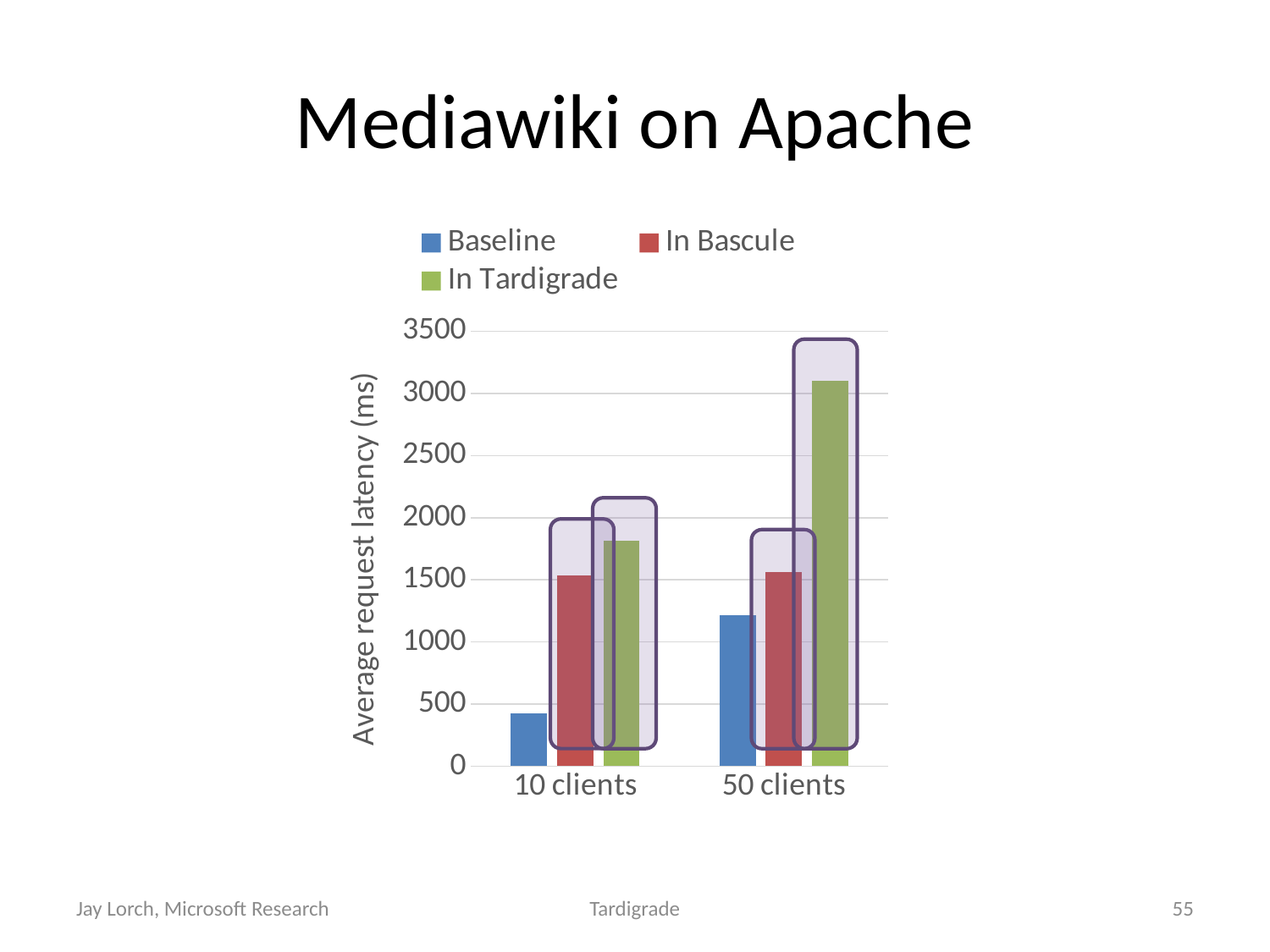
What is the title of the slide containing the chart? Mediawiki on Apache Is the In Bascule value for 10 clients greater or less than 1000? greater How many series does the legend list? 3 Which is larger for 50 clients: In Bascule or In Tardigrade? In Tardigrade Which series has the lowest average request latency for 10 clients? Baseline Is the In Tardigrade value for 50 clients greater or less than 3000? greater What kind of chart is shown on the slide? bar chart Is the Baseline value for 10 clients greater or less than 500? less How many categories are shown on the x axis? 2 Which series has the highest average request latency for 50 clients? In Tardigrade Which is larger: the Baseline value for 10 clients or the Baseline value for 50 clients? 50 clients What is the label of the y axis? Average request latency (ms)